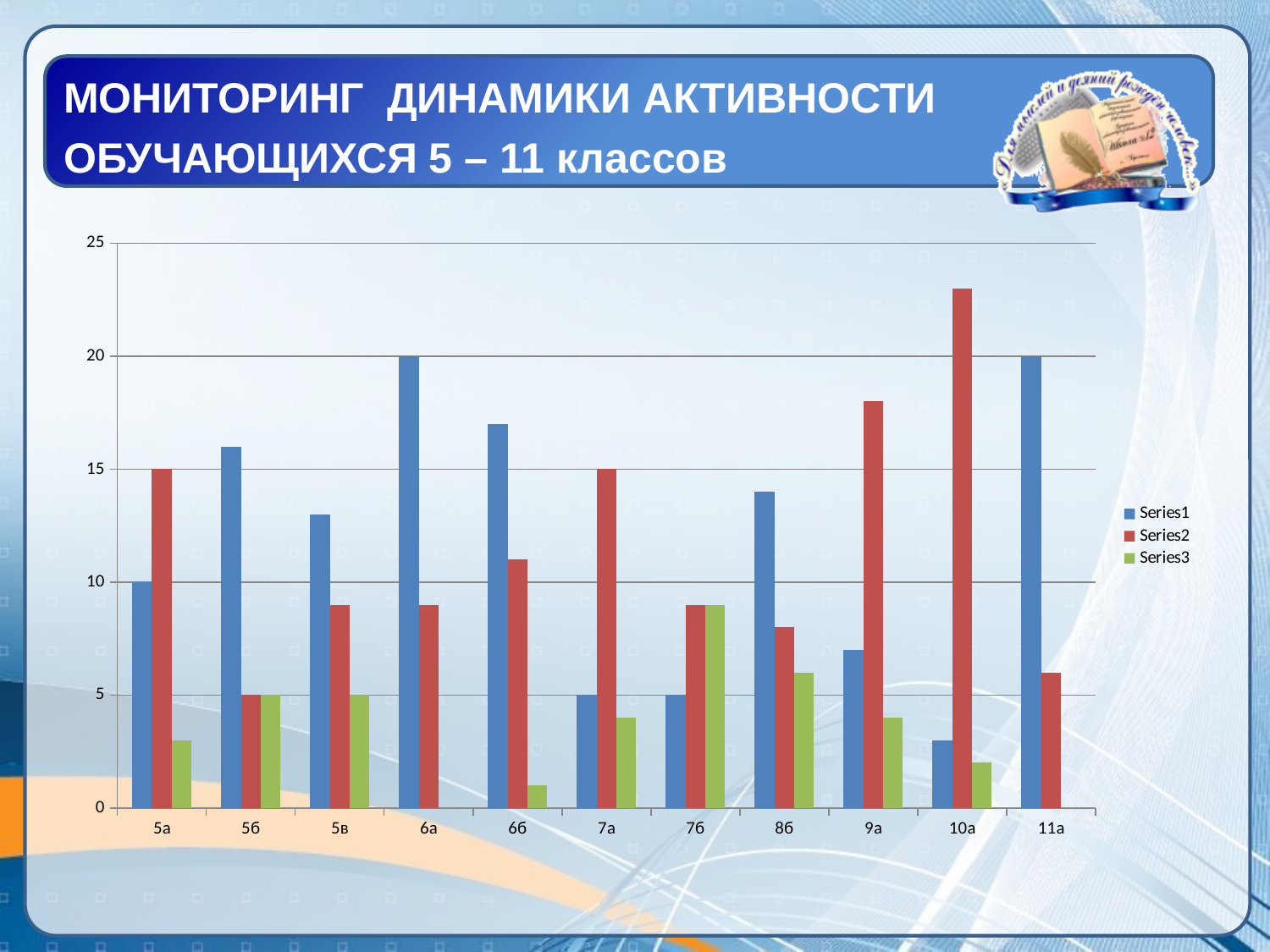
Is the value of Series2 for 9а greater or less than 15? greater What is the difference between Series2 and Series1 for 5а? 5 How many series does the legend list? 3 What is the value of Series1 for 5а? 10 Which category has the highest Series2 value? 10а What is the value of Series2 for 5а? 15 What is the value of Series1 for 6а? 20 What kind of chart is shown on the slide? bar chart What is the value of Series2 for 7а? 15 For 10а, which is larger: Series1 or Series2? Series2 How many categories are shown on the x axis? 11 Which category has the lowest Series1 value? 10а